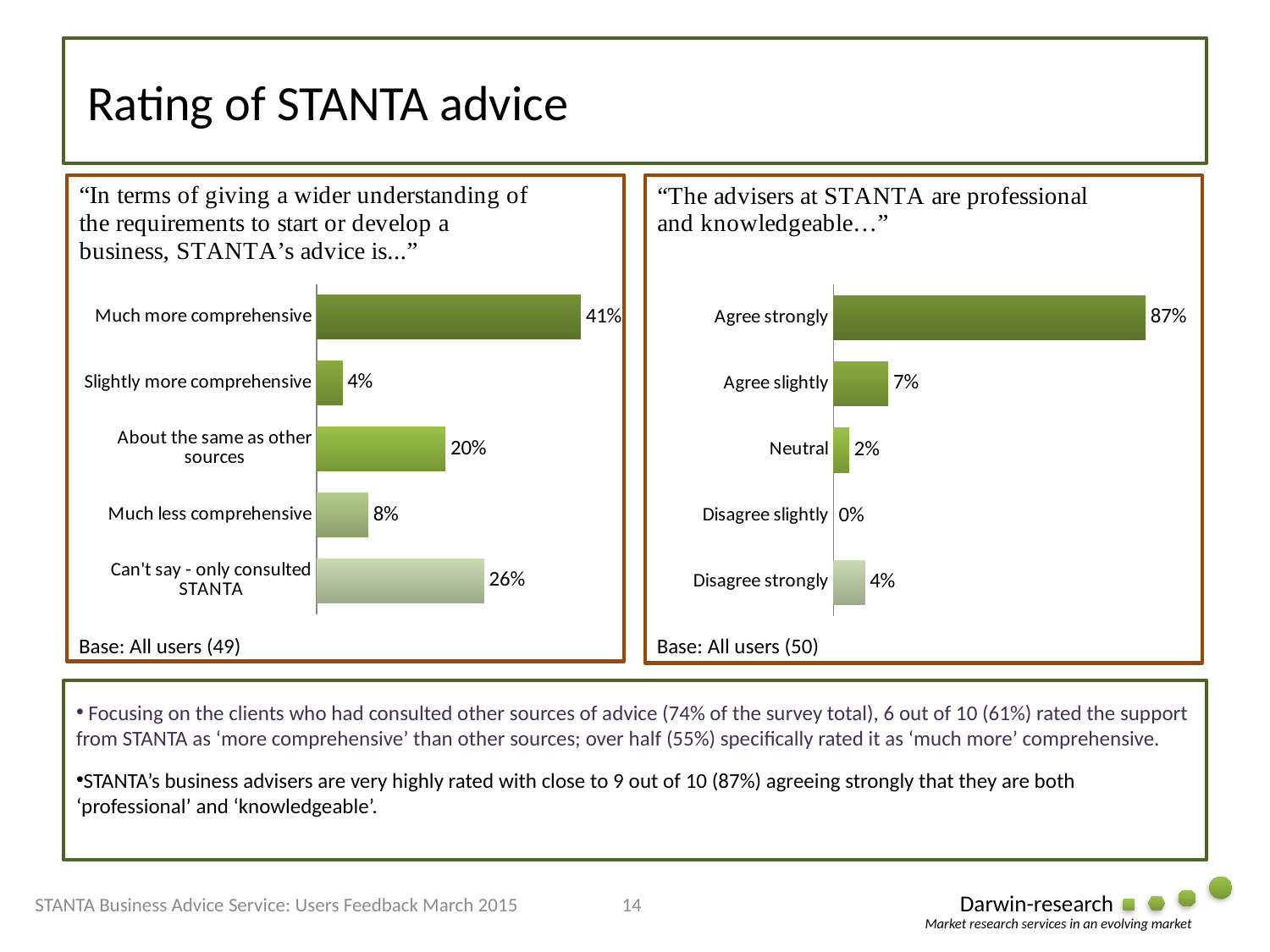
What is the base (number of users) stated for the left chart ("STANTA's advice is...")? All users (49) In the left chart ("STANTA's advice is..."), how many categories are shown? 5 What type of chart is the right chart ("The advisers at STANTA are professional and knowledgeable...")? Bar chart In the left chart ("STANTA's advice is..."), what is the difference between 'Can't say - only consulted STANTA' and 'Much less comprehensive'? 18% In the left chart ("STANTA's advice is..."), what percentage said 'About the same as other sources'? 20% In the right chart ("The advisers at STANTA are professional and knowledgeable..."), what percentage disagree slightly? 0% In the right chart ("The advisers at STANTA are professional and knowledgeable..."), what percentage agree strongly? 87% In the left chart ("STANTA's advice is..."), what percentage of users said the advice is much more comprehensive? 41% In the right chart ("The advisers at STANTA are professional and knowledgeable..."), what is the difference between Agree strongly and Agree slightly? 80% In the right chart ("The advisers at STANTA are professional and knowledgeable..."), which category has the highest value? Agree strongly In the left chart ("STANTA's advice is..."), which category has the lowest value? Slightly more comprehensive In the right chart ("The advisers at STANTA are professional and knowledgeable..."), which is larger: Agree slightly or Disagree strongly? Agree slightly